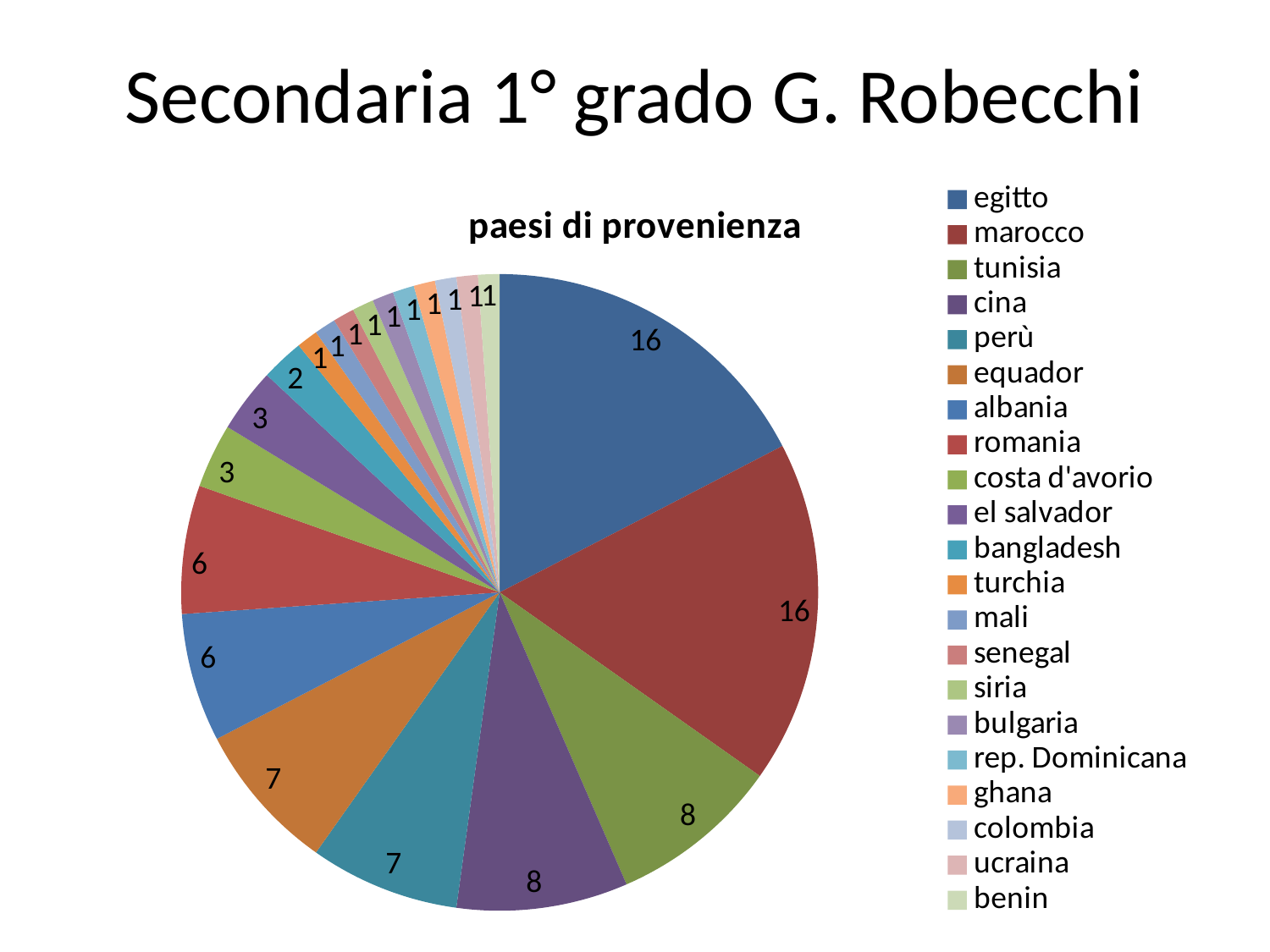
What is the value for albania in the pie chart? 6 Which has the larger value, equador or romania? equador How many countries are listed in the legend of the pie chart? 21 What is the value for costa d'avorio in the pie chart? 3 What is the title of the pie chart? paesi di provenienza What is the value for tunisia in the pie chart? 8 What is the difference between the values for marocco and perù? 9 Which has the larger value, cina or el salvador? cina What is the value for bangladesh in the pie chart? 2 What is the value for egitto in the pie chart? 16 What kind of chart is shown on the slide? pie chart What is the total of all the slice values in the pie chart? 92